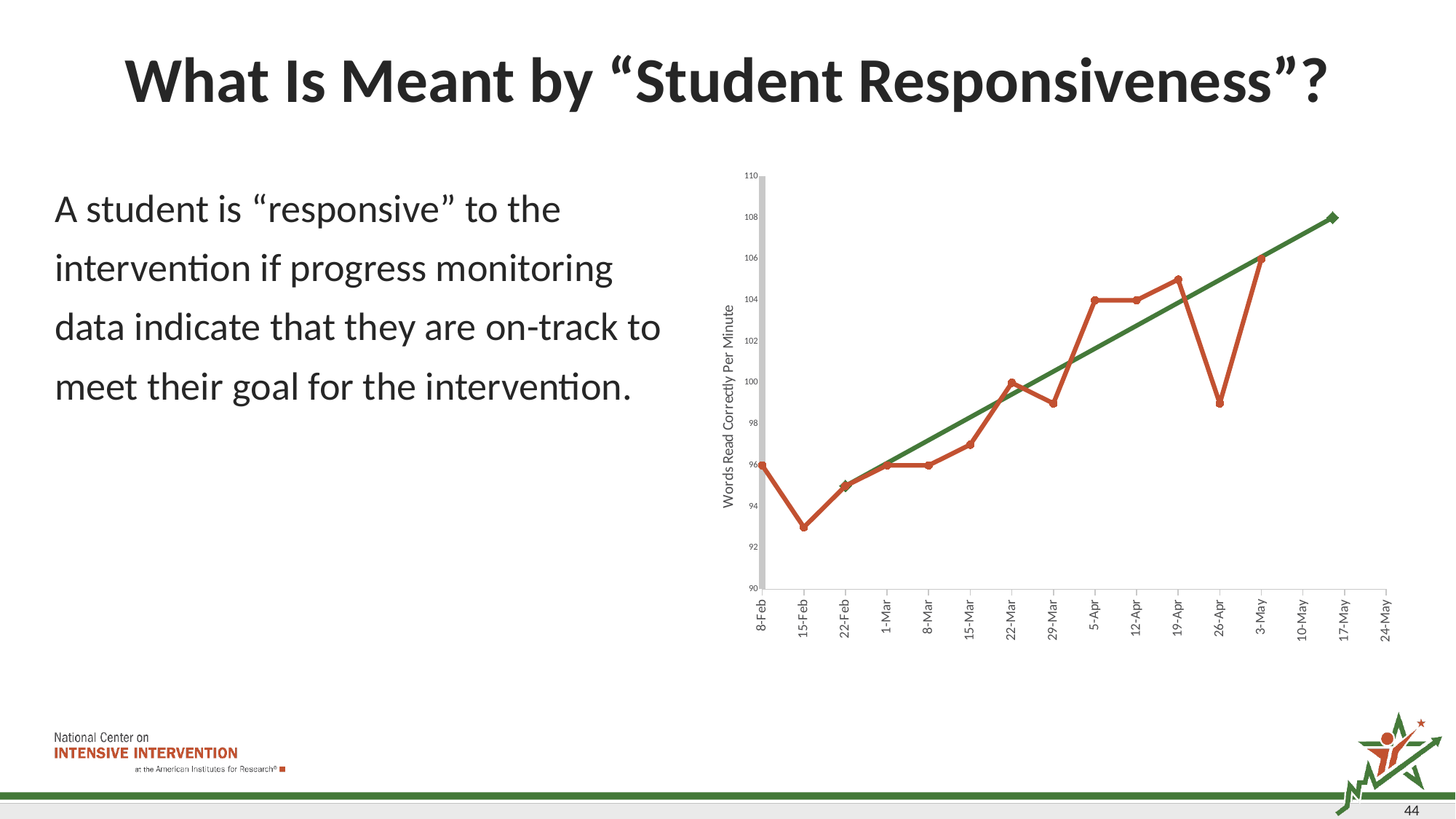
What value does the green goal line reach at 17-May? 108 On which date does the red line reach its highest point? 3-May Is the value of the red line on 19-Apr greater or less than 102? greater What is the y-axis title of the chart? Words Read Correctly Per Minute On which date is the red line at its lowest point? 15-Feb What value does the red line reach on 22-Mar? 100 Is the value of the red line on 15-Feb greater or less than 94? less Does the green goal line rise or fall from left to right? rise Which date has the higher value on the red line, 5-Apr or 26-Apr? 5-Apr What value does the red line reach on 3-May? 106 What kind of chart is shown on the slide? line chart How many dates are labelled on the x axis? 16